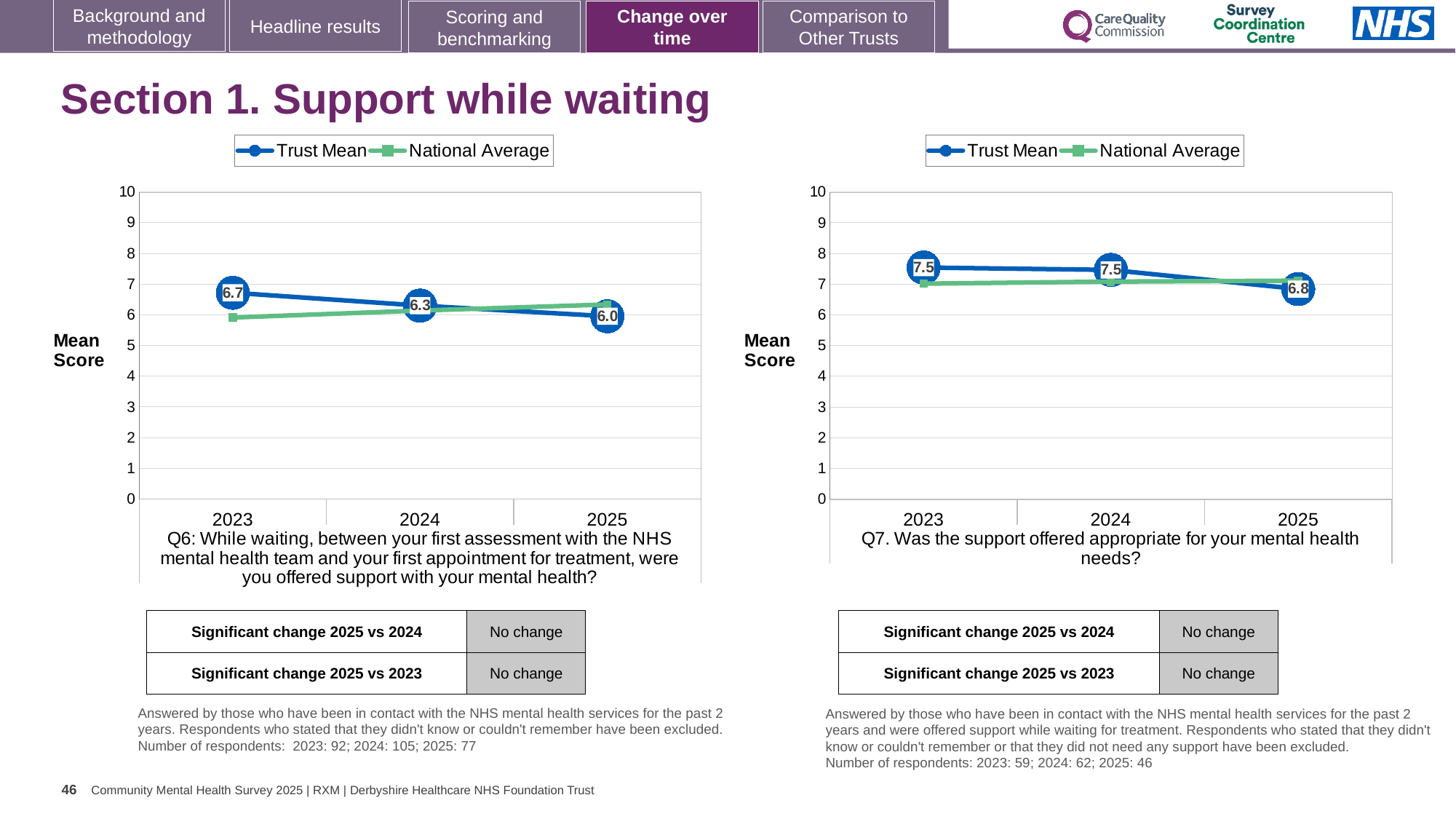
On the right chart (Q7), what is the Trust Mean score for 2024? 7.5 On the left chart (Q6), is the National Average for 2025 greater or less than 5? greater On the left chart (Q6), in which year is the Trust Mean highest? 2023 On the right chart (Q7), is the Trust Mean for 2023 larger or smaller than the Trust Mean for 2025? larger What kind of chart is the left chart (Q6)? line chart On the left chart (Q6), does the Trust Mean rise or fall from 2023 to 2025? fall How many series does the legend of the right chart (Q7) list? 2 On the left chart (Q6), what is the Trust Mean score for 2023? 6.7 On the right chart (Q7), in which year is the Trust Mean lowest? 2025 On the right chart (Q7), what is the Trust Mean score for 2025? 6.8 On the left chart (Q6), what is the difference between the Trust Mean in 2023 and in 2025? 0.7 On the left chart (Q6), what is the Trust Mean score for 2025? 6.0